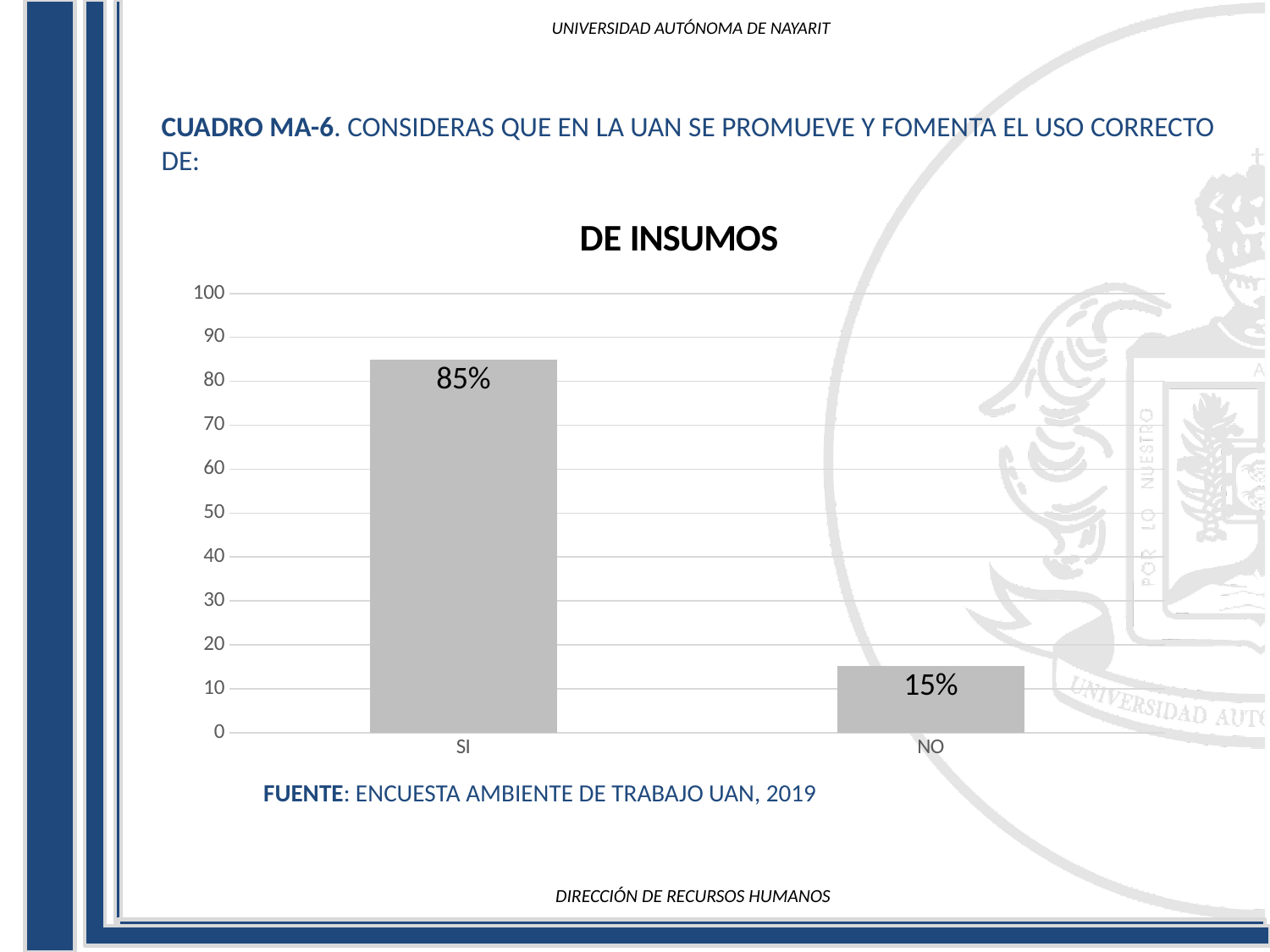
What is the value for SI? 85% How many categories are shown on the x axis? 2 Which is larger, the value for SI or the value for NO? SI Which category has the lowest value? NO What is the title of the chart? DE INSUMOS What is the maximum value shown on the y axis? 100 Is the value for SI greater or less than 80? greater Is the value for NO greater or less than 20? less What kind of chart is shown? bar chart Which category has the highest value? SI What is the difference between the values for SI and NO? 70% What is the value for NO? 15%